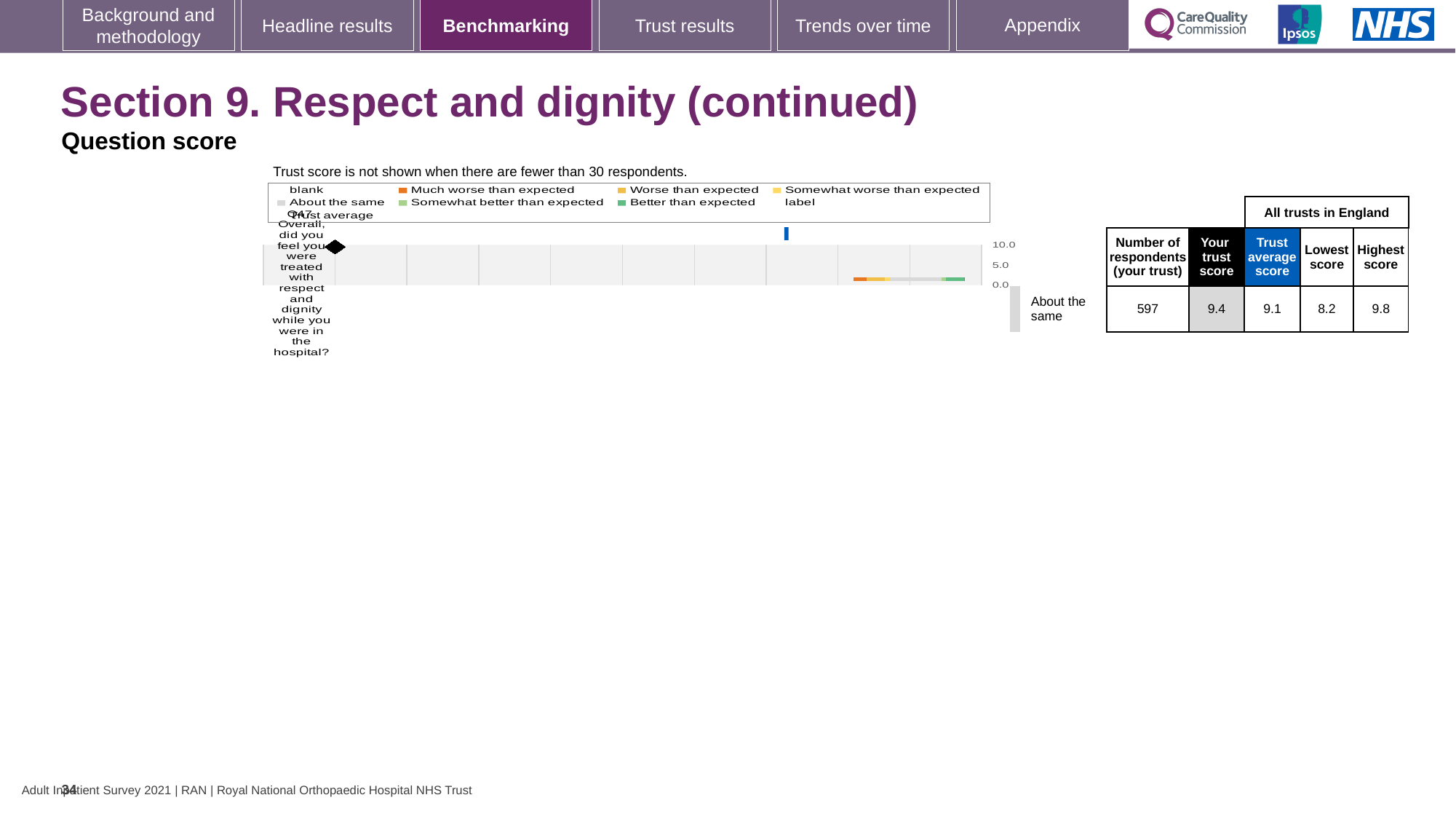
What is the highest score across all trusts in England for this question? 9.8 What is the trust score for the question about being treated with respect and dignity? 9.4 How many survey questions are plotted on the chart? 1 Which is larger, the trust's own score or the trust average score? Your trust score What is the trust average score for the question about being treated with respect and dignity? 9.1 What is the difference between the highest and lowest scores across all trusts in England? 1.6 What kind of chart is shown on the slide? bar chart Is the trust score for this question greater or less than 5.0? greater How many respondents from the trust answered this question? 597 How is the trust's result for this question categorised relative to expectations? About the same What is the lowest score across all trusts in England for this question? 8.2 According to the note above the chart, below how many respondents is the trust score not shown? 30